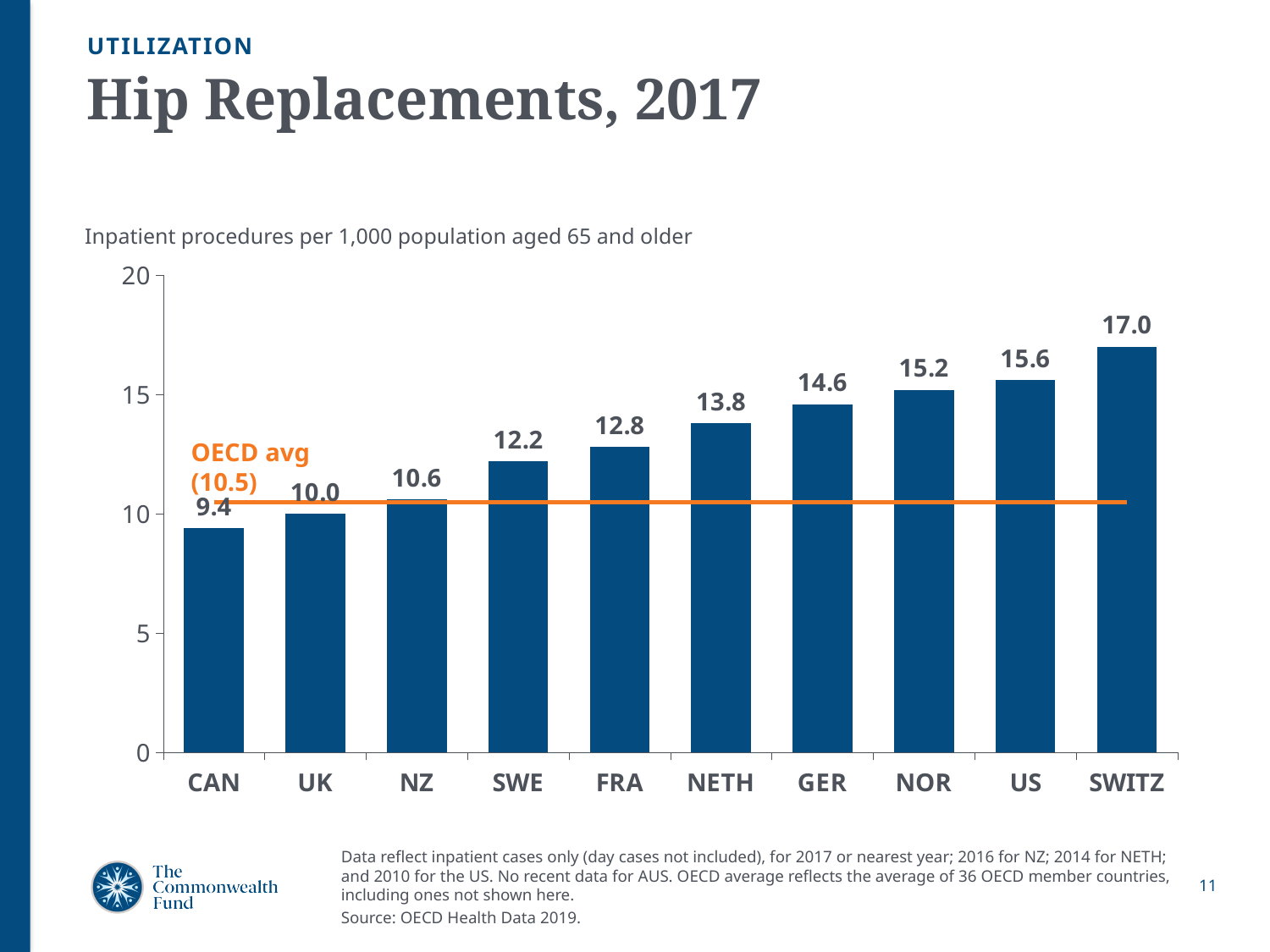
Is the value for SWE greater or less than 10? greater Which country has the highest value? SWITZ What is the value for the US? 15.6 What is the value for NETH? 13.8 Do the values rise or fall from left to right along the x axis? rise What is the difference between the values for SWITZ and CAN? 7.6 What kind of chart is this? bar chart What is the OECD average shown on the chart? 10.5 What is the title of the chart? Hip Replacements, 2017 Which country has the lowest value? CAN How many countries are shown on the chart? 10 Which is larger, the value for GER or the value for FRA? GER